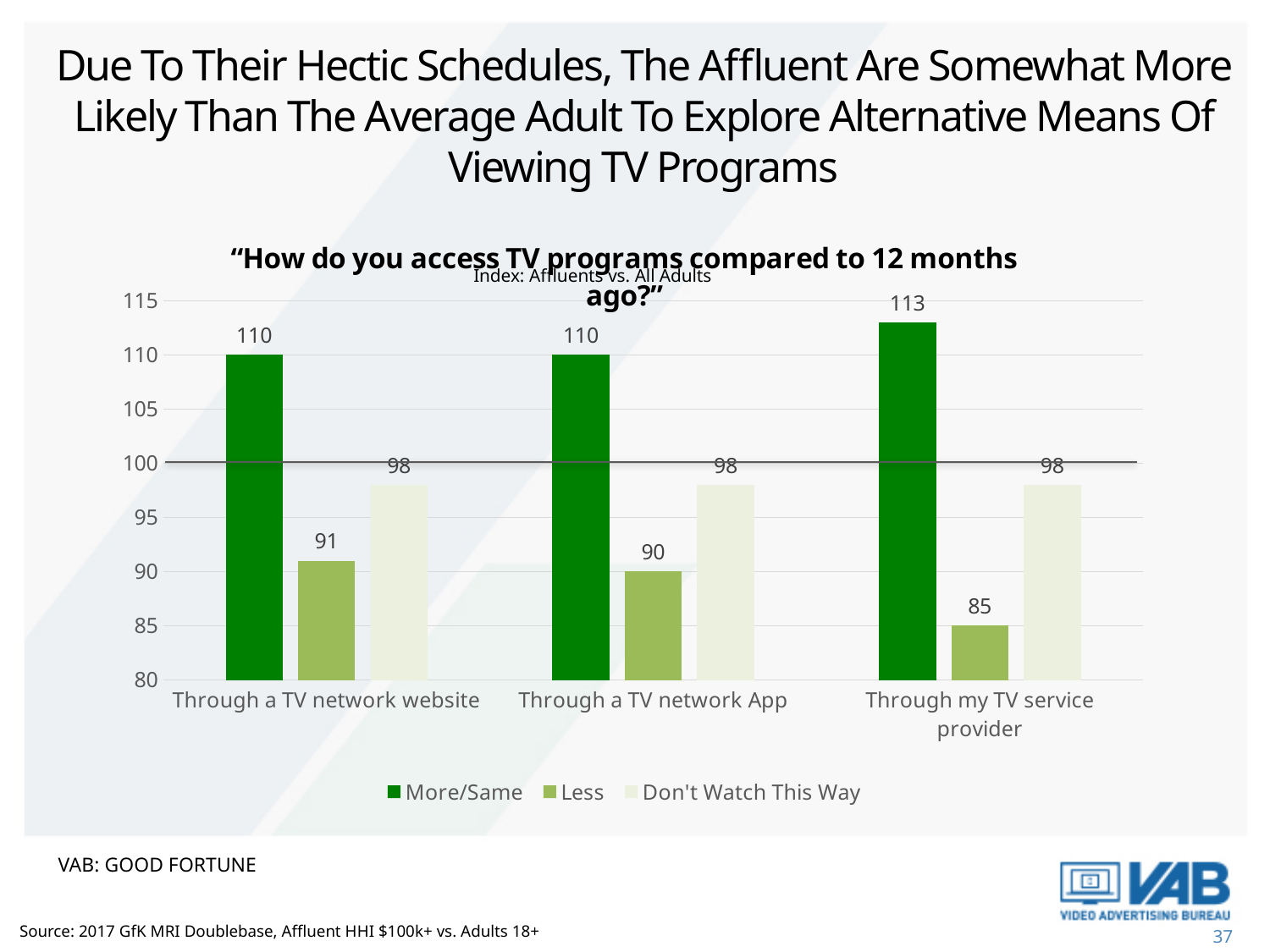
How many series does the legend list? 3 What is the More/Same index value for Through my TV service provider? 113 What is the Don't Watch This Way index value for Through a TV network website? 98 Which category has the highest More/Same value? Through my TV service provider Which is larger for Through a TV network website: the Less value or the Don't Watch This Way value? Don't Watch This Way What kind of chart is shown on the slide? bar chart Is the Less value for Through my TV service provider greater or less than 90? less Which category has the lowest Less value? Through my TV service provider How many categories are shown on the x axis? 3 What is the Less index value for Through a TV network App? 90 What is the difference between the More/Same and Less values for Through my TV service provider? 28 Which series is shown in the darkest green colour? More/Same